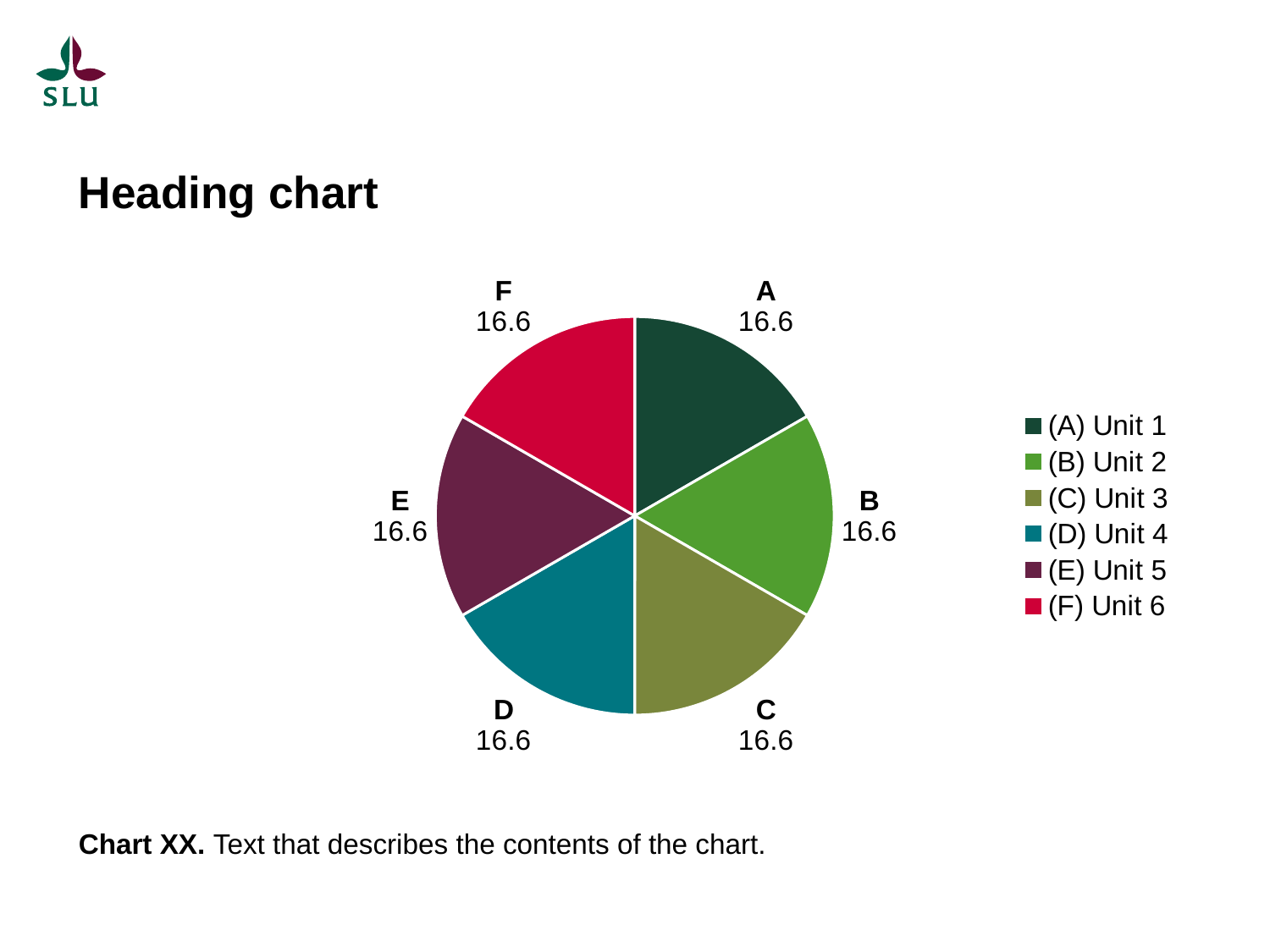
What is the title of the chart? Heading chart How many entries does the legend list? 6 What is the value shown for slice A? 16.6 Do all slices of the pie chart have the same value? Yes What legend label corresponds to slice D? (D) Unit 4 How many slices does the pie chart have? 6 What is the value shown for slice C? 16.6 What is the value shown for slice F? 16.6 What is the value shown for slice D? 16.6 What kind of chart is shown on the slide? pie chart What is the difference between the values for slice A and slice B? 0